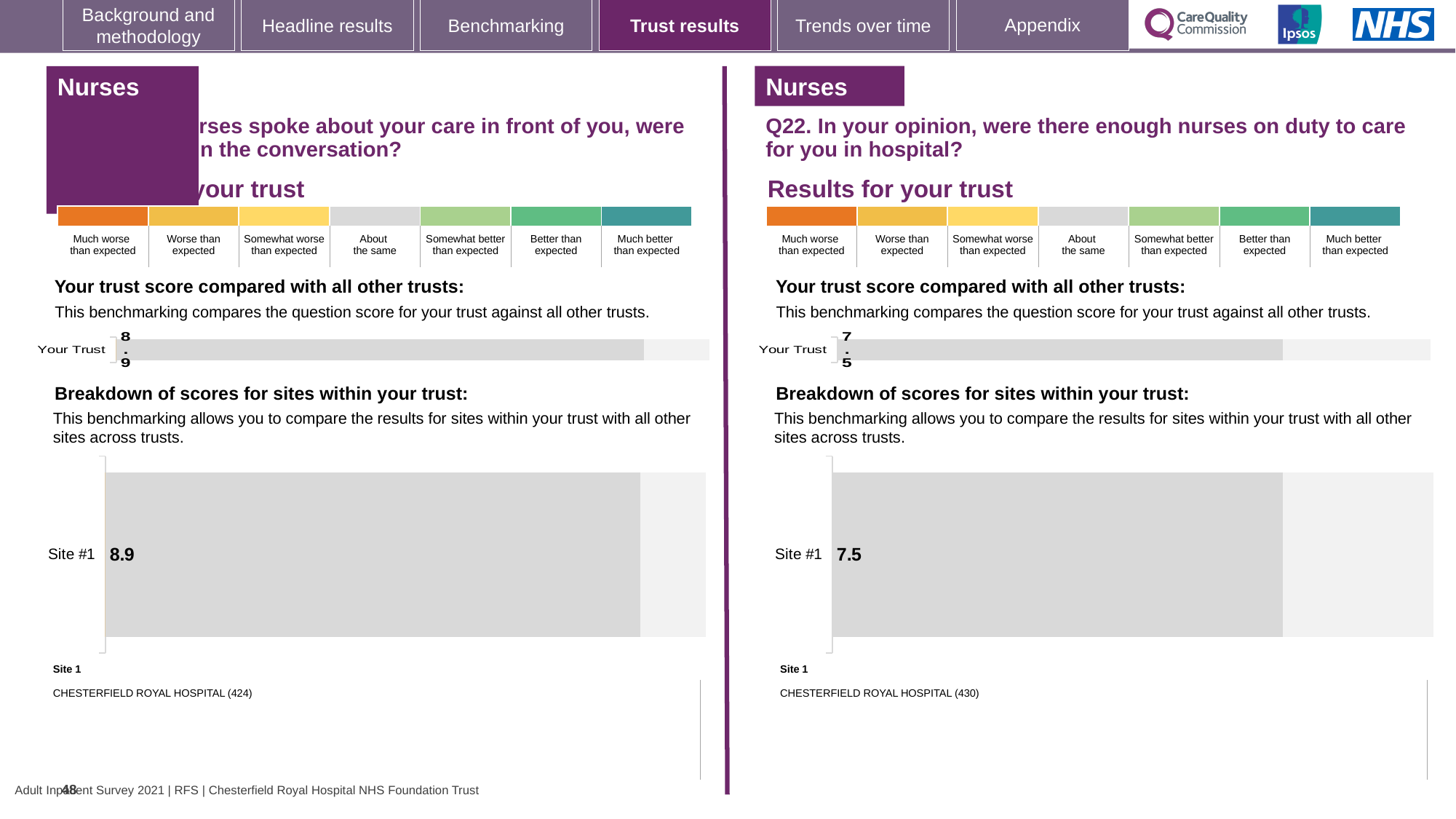
Which site is labelled as Site 1 beneath the site breakdown chart on the left half of the slide? CHESTERFIELD ROYAL HOSPITAL (424) How many sites are plotted in the 'Breakdown of scores for sites within your trust' chart for Q22 on the right half of the slide? 1 On the left half of the slide, what is the 'Your Trust' score shown in the trust benchmarking bar chart? 8.9 Which site is labelled as Site 1 beneath the Q22 site breakdown chart on the right half of the slide? CHESTERFIELD ROYAL HOSPITAL (430) What type of chart is used to show the Site #1 score in the site breakdown section for Q22 on the right half of the slide? Bar chart In the 'Breakdown of scores for sites within your trust' chart on the left half of the slide, what is the score for Site #1? 8.9 On the right half of the slide (Q22), what is the 'Your Trust' score shown in the trust benchmarking bar chart? 7.5 How many sites are plotted in the 'Breakdown of scores for sites within your trust' chart on the left half of the slide? 1 Which is larger: the Site #1 score in the left-hand site breakdown chart or the Site #1 score in the right-hand (Q22) site breakdown chart? The left-hand chart (8.9) What is the difference between the Site #1 score on the left half of the slide (8.9) and the Site #1 score for Q22 on the right half (7.5)? 1.4 What type of chart is used to show the 'Your Trust' score on the left half of the slide? Bar chart In the 'Breakdown of scores for sites within your trust' chart for Q22 on the right half of the slide, what is the score for Site #1? 7.5